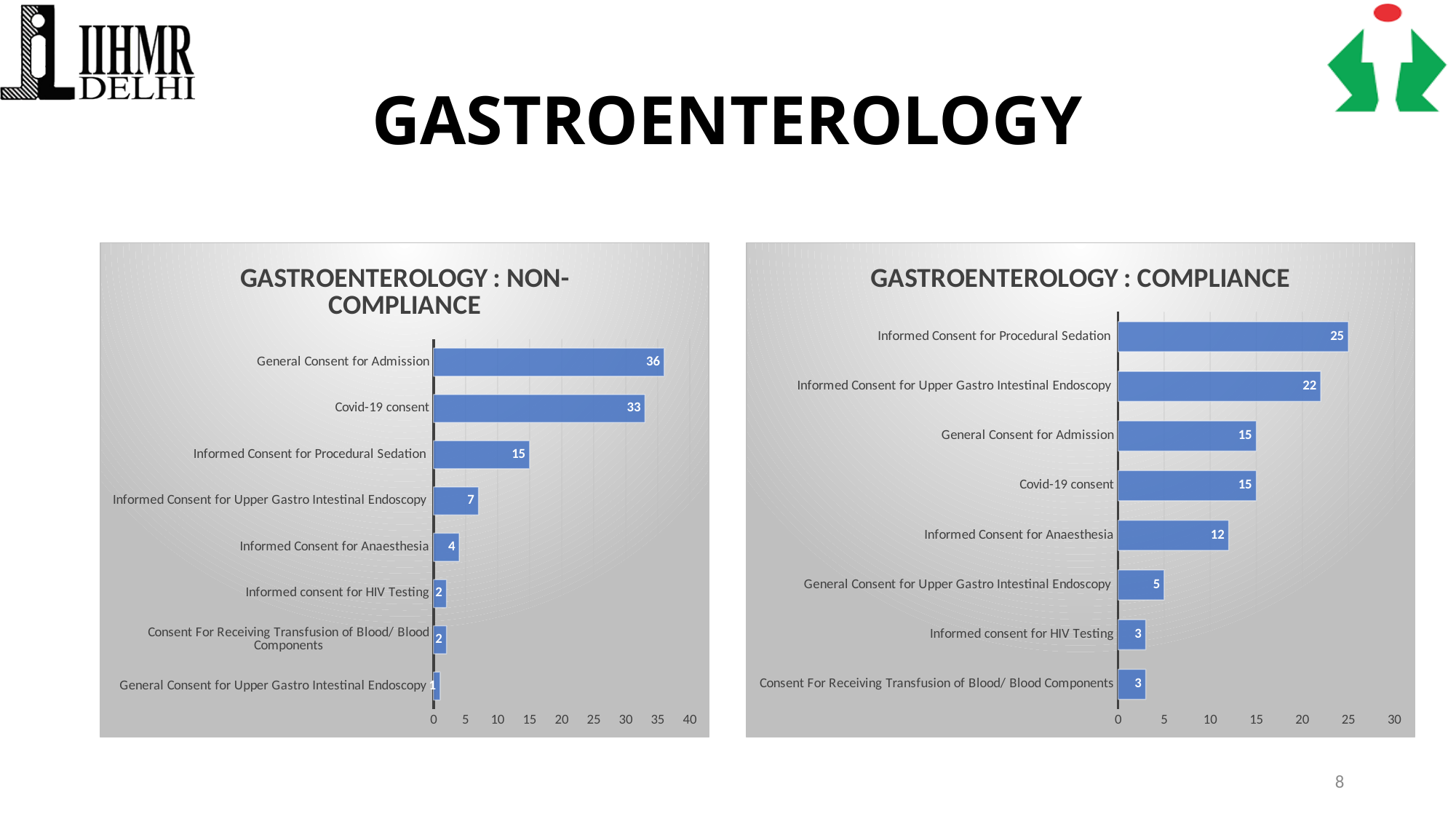
In the GASTROENTEROLOGY : NON-COMPLIANCE chart, what is the difference between the values for General Consent for Admission and Covid-19 consent? 3 How many categories are shown in the GASTROENTEROLOGY : COMPLIANCE chart? 8 In the GASTROENTEROLOGY : COMPLIANCE chart, what is the value for Informed consent for HIV Testing? 3 What kind of chart is the GASTROENTEROLOGY : NON-COMPLIANCE chart? Bar chart In the GASTROENTEROLOGY : NON-COMPLIANCE chart, which category has the lowest value? General Consent for Upper Gastro Intestinal Endoscopy In the GASTROENTEROLOGY : COMPLIANCE chart, what is the value for Informed Consent for Anaesthesia? 12 In the GASTROENTEROLOGY : COMPLIANCE chart, what is the difference between the values for Informed Consent for Procedural Sedation and Informed Consent for Upper Gastro Intestinal Endoscopy? 3 In the GASTROENTEROLOGY : NON-COMPLIANCE chart, what is the value for General Consent for Admission? 36 In the GASTROENTEROLOGY : NON-COMPLIANCE chart, which is larger: Informed Consent for Procedural Sedation or Informed Consent for Upper Gastro Intestinal Endoscopy? Informed Consent for Procedural Sedation In the GASTROENTEROLOGY : COMPLIANCE chart, is the value for Informed Consent for Upper Gastro Intestinal Endoscopy greater or less than 20? greater What is the title of the chart on the left side of the slide? GASTROENTEROLOGY : NON-COMPLIANCE In the GASTROENTEROLOGY : COMPLIANCE chart, which category has the highest value? Informed Consent for Procedural Sedation